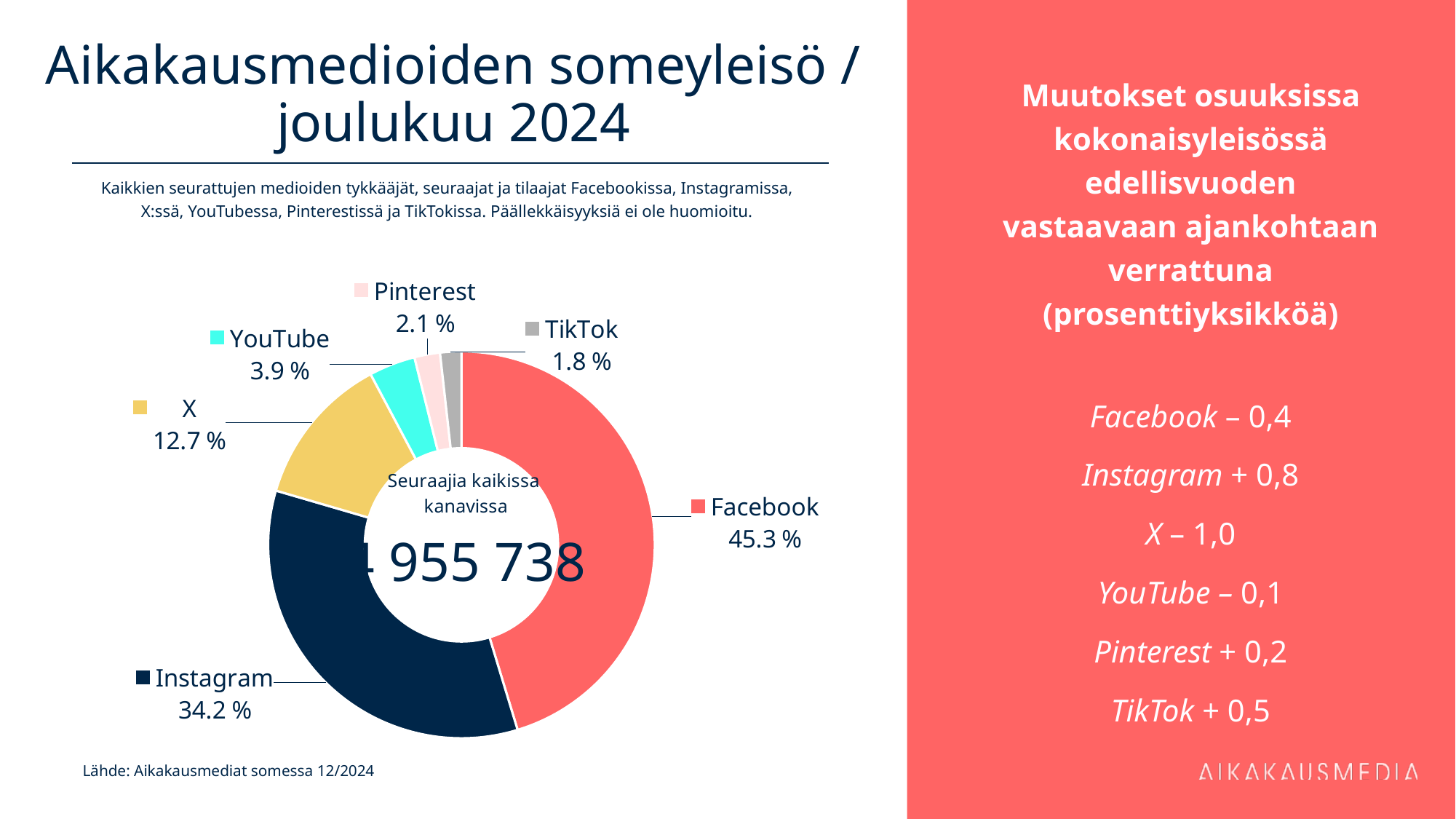
What share of the social media audience does X have? 12.7 % What share of the social media audience does Facebook have? 45.3 % What kind of chart is shown on the slide? Doughnut (pie) chart What is the difference in percentage points between Facebook's and Instagram's shares? 11.1 What share of the social media audience does Instagram have? 34.2 % How many channels are shown in the chart? 6 What share of the social media audience does TikTok have? 1.8 % Which channel has the largest share of the audience? Facebook Which has a larger share, Pinterest or YouTube? YouTube What share of the social media audience does YouTube have? 3.9 % Which channel has the smallest share of the audience? TikTok What is the title of the slide? Aikakausmedioiden someyleisö / joulukuu 2024